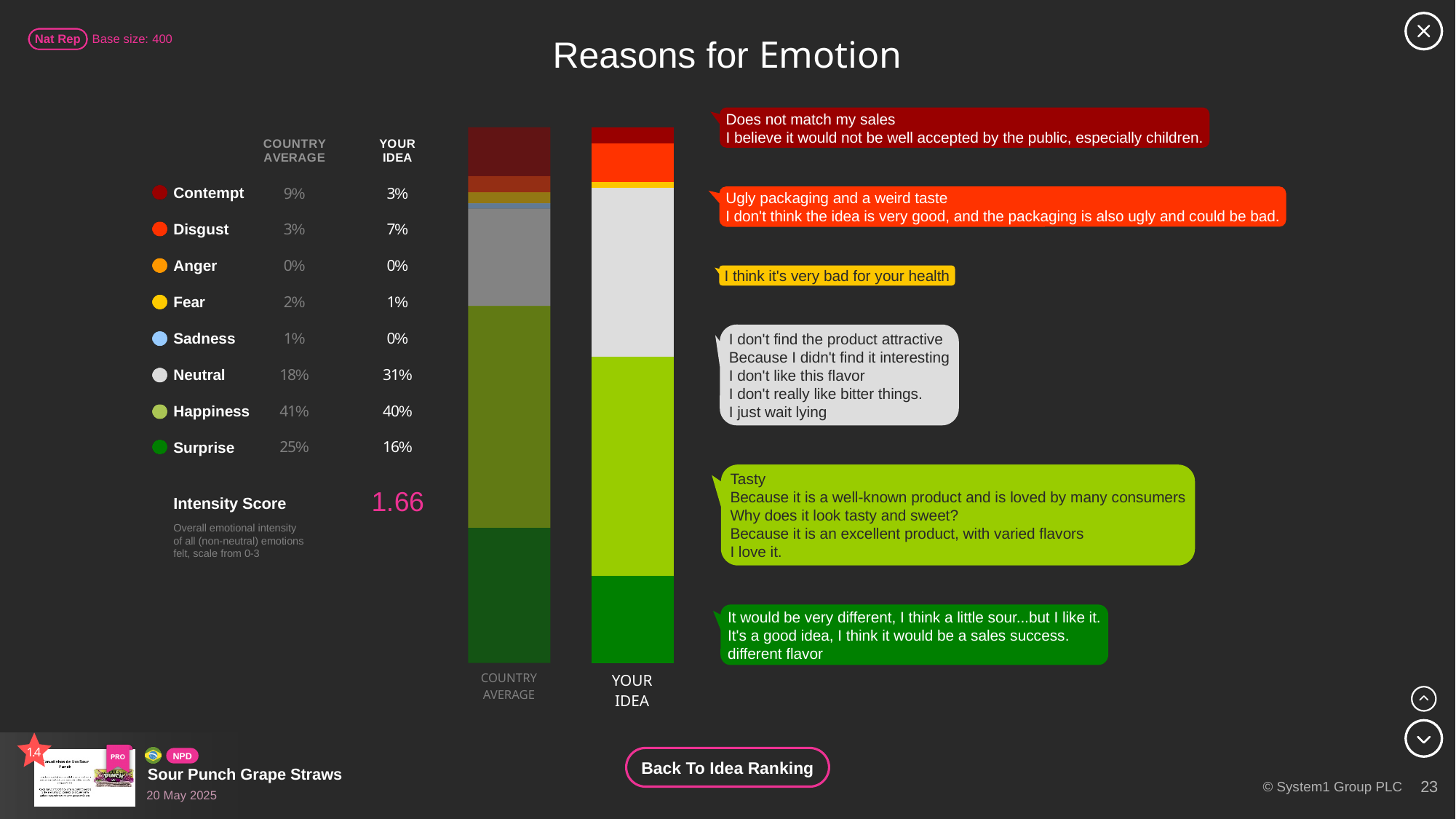
What is the difference between the Neutral value for Your Idea and the Country Average? 13 percentage points Which emotion has the highest value for the Country Average? Happiness What kind of chart is shown on the slide? Stacked bar chart What is the difference between the Contempt value for the Country Average and Your Idea? 6 percentage points How many emotion categories are listed in the chart? 8 Is the Surprise value larger for the Country Average or for Your Idea? Country Average What is the Happiness value for Your Idea? 40% What is the Surprise value for the Country Average? 25% What is the Neutral value for Your Idea? 31% What is the Intensity Score shown on the slide? 1.66 Which emotion has the highest value for Your Idea? Happiness What is the Disgust value for the Country Average? 3%